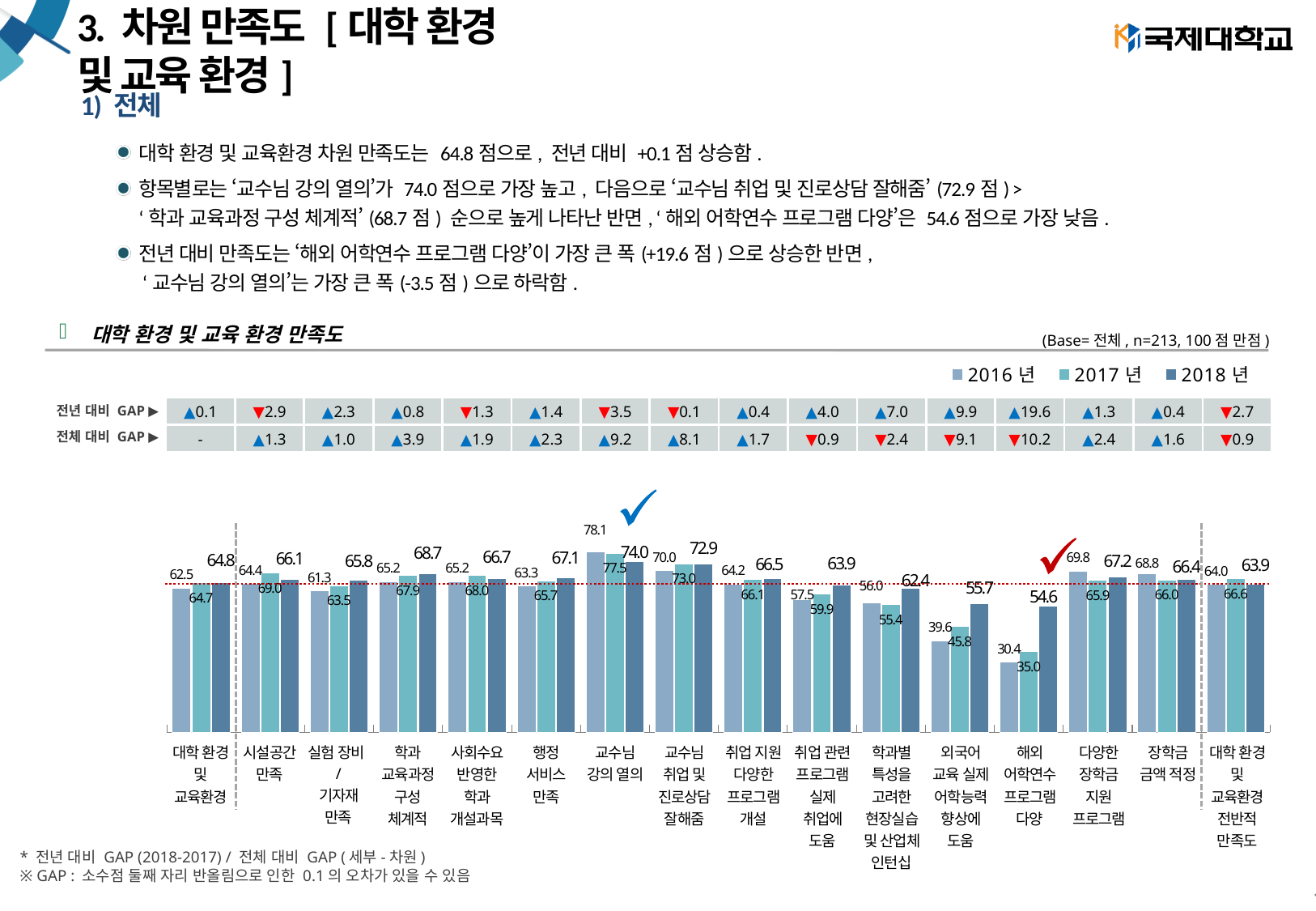
What kind of chart is shown on the slide? Bar chart Which category has the highest 2018년 value? 교수님 강의 열의 What is the difference between the 2018년 and 2017년 values for '해외 어학연수 프로그램 다양'? 19.6 Which is larger for '다양한 장학금 지원 프로그램': the 2016년 value or the 2018년 value? 2016년 Do the values for '외국어 교육 실제 어학능력 향상에 도움' rise or fall from 2016년 to 2018년? Rise Which category has the lowest 2018년 value? 해외 어학연수 프로그램 다양 What is the 2016년 value for '해외 어학연수 프로그램 다양'? 30.4 How many series does the legend list? 3 Which series is shown in the darkest blue colour in the legend? 2018년 What is the 2018년 value for '교수님 강의 열의'? 74.0 What is the 2017년 value for '시설공간 만족'? 69.0 What is the difference between the 2016년 and 2018년 values for '교수님 강의 열의'? 4.1